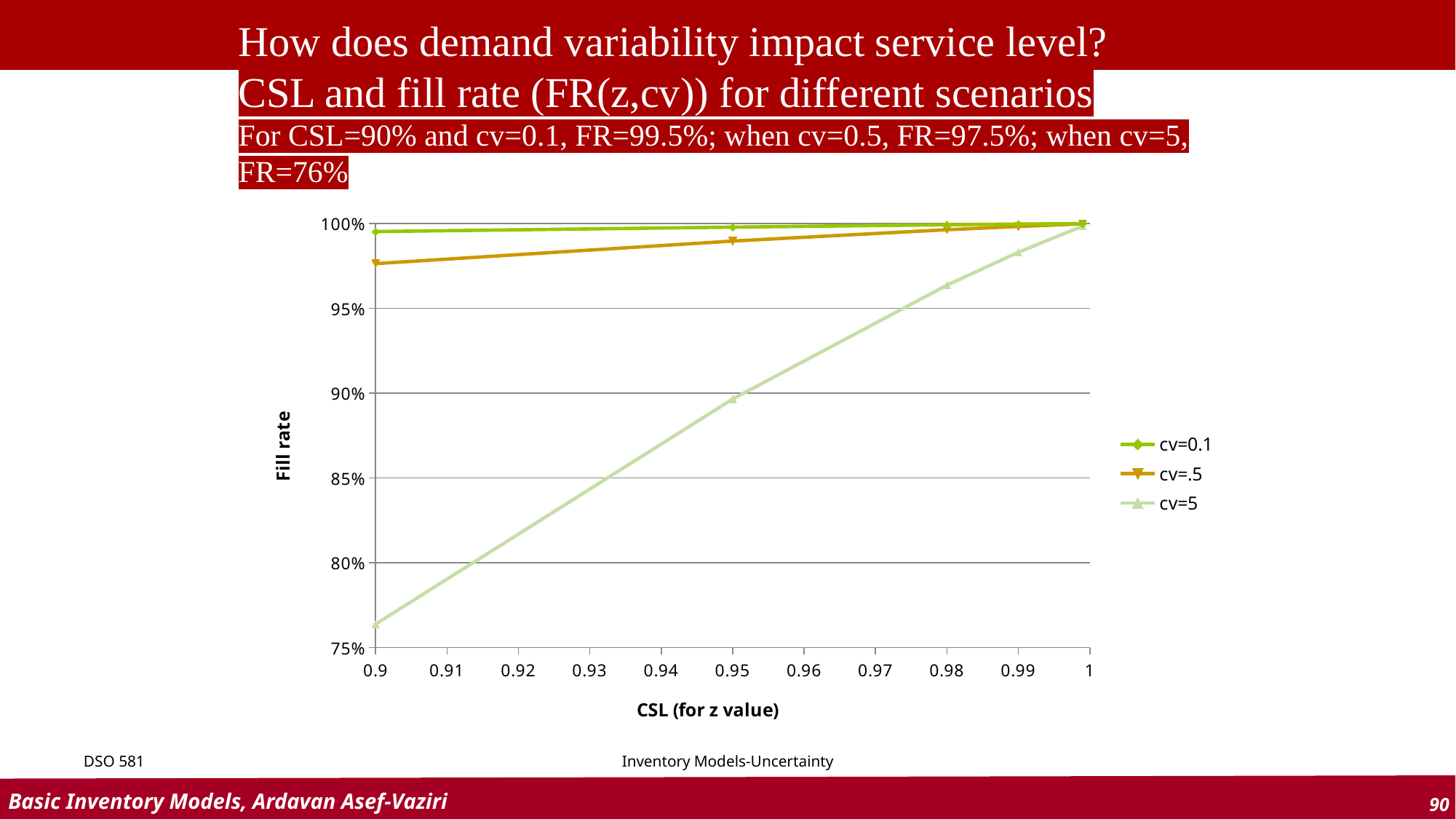
At CSL=0.9, which is larger: the fill rate for cv=0.1 or for cv=5? cv=0.1 How many series does the legend list? 3 What is the difference between the fill rate for cv=0.1 and for cv=5 at CSL=90%, using the values stated on the slide? 23.5 percentage points What is the label on the x axis of the chart? CSL (for z value) According to the slide, what is the fill rate for cv=0.1 at CSL=90%? 99.5% Is the fill rate for cv=5 at CSL=0.9 greater or less than 80%? less Does the fill rate for cv=5 rise or fall as CSL increases from 0.9 to 1? rise What is the label on the y axis of the chart? Fill rate Which series has the lowest fill rate at CSL=0.9? cv=5 According to the slide, what is the fill rate for cv=5 at CSL=90%? 76% What kind of chart is shown on the slide? line chart